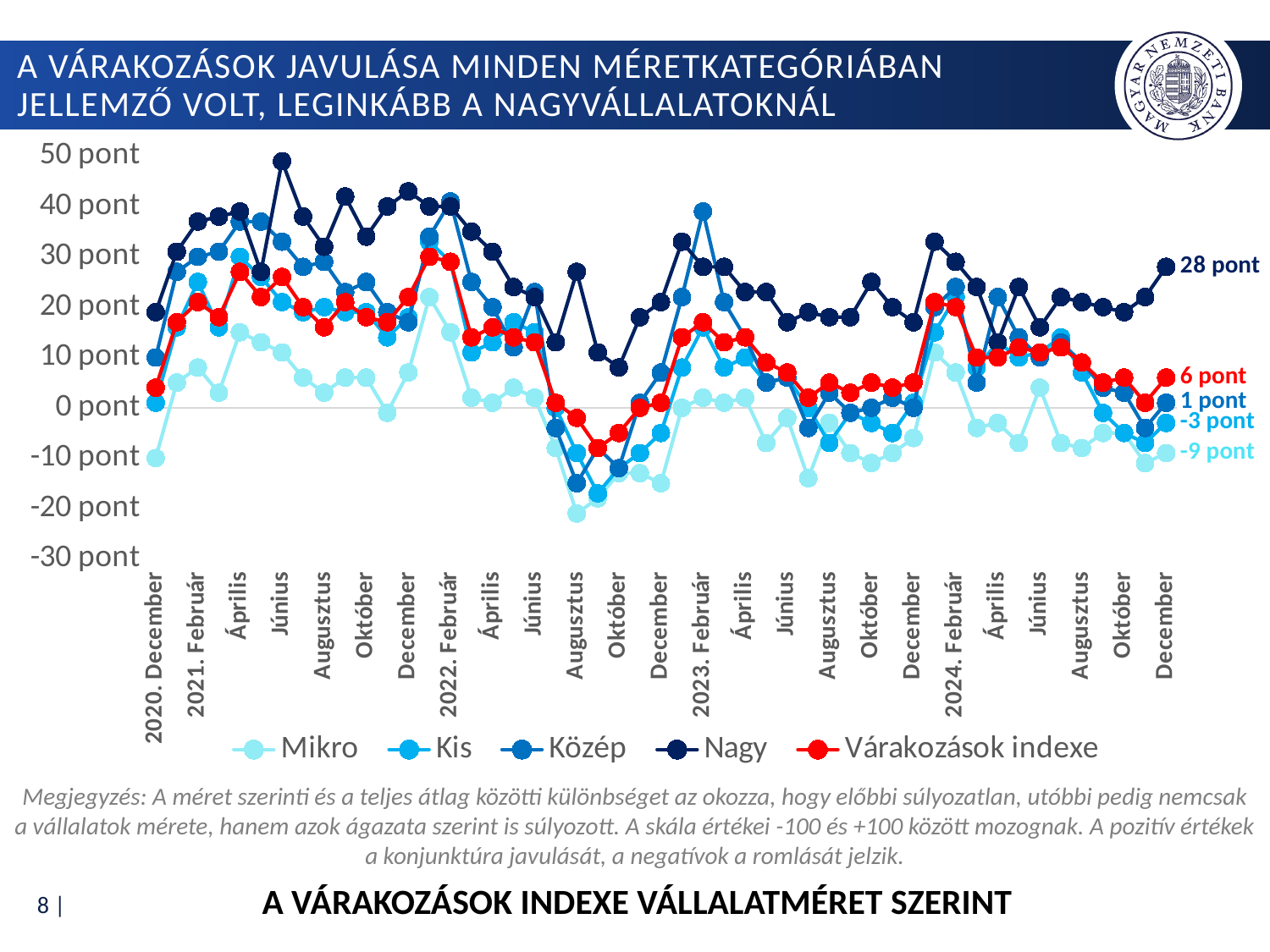
Is the value of the Nagy series in 2021 Június greater or less than 40 pont? greater What kind of chart is shown on the slide? Line chart Which series has the lowest value at the last point (2024 December)? Mikro What is the value of the Mikro series at the last point (2024 December)? -9 pont What is the value of the Nagy series at the last point (2024 December)? 28 pont At the last point (2024 December), which is larger: the Közép value or the Kis value? Közép What is the value of the Várakozások indexe series at the last point (2024 December)? 6 pont Which series has the highest value at the last point (2024 December)? Nagy What is the value of the Kis series at the last point (2024 December)? -3 pont What is the difference between the Nagy and Mikro values at the last point (2024 December)? 37 pont What is the difference between the Nagy and Várakozások indexe values at the last point (2024 December)? 22 pont How many series does the legend list? 5